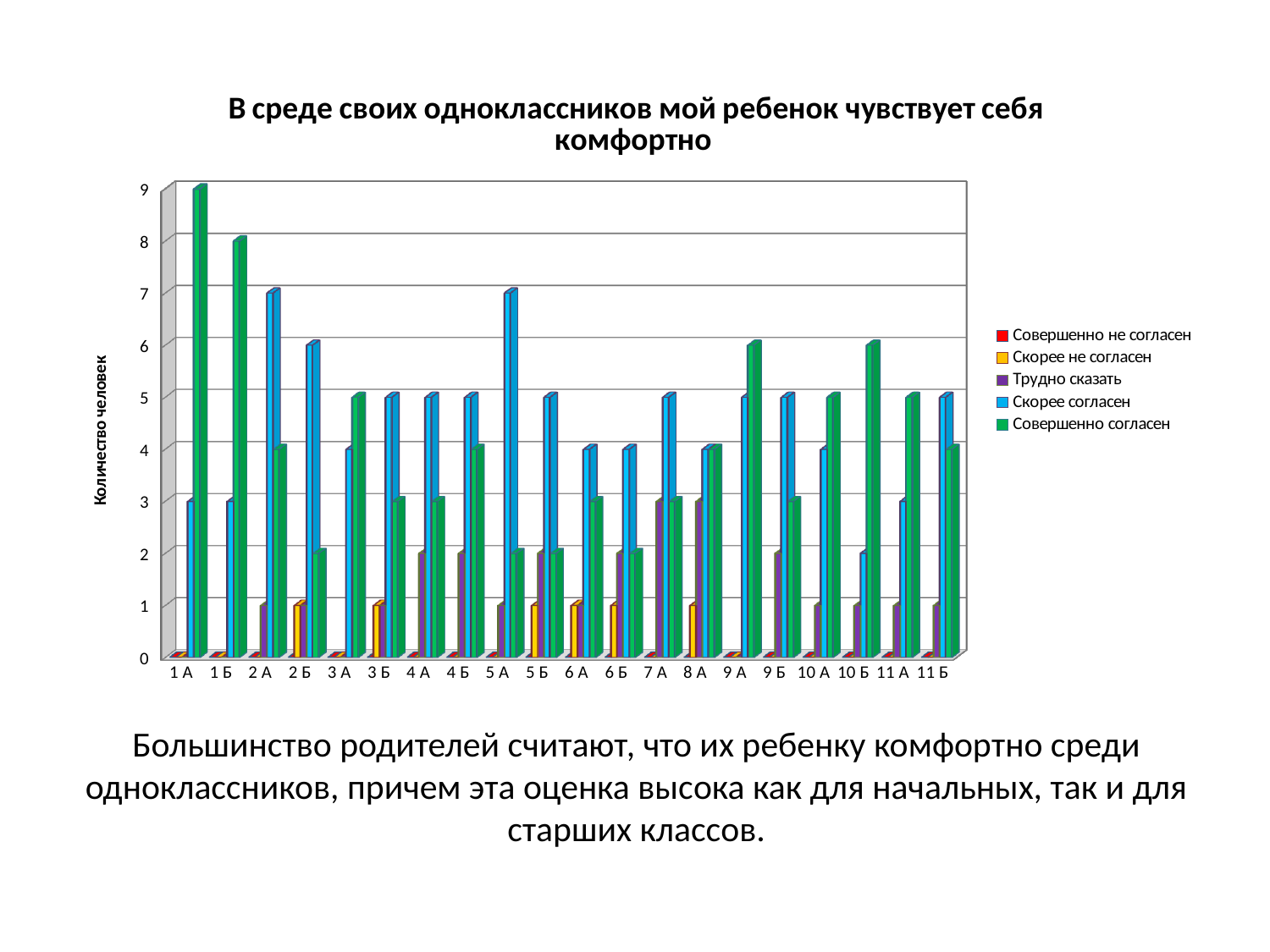
What kind of chart is shown on the slide? bar chart What is the value for 'Совершенно согласен' in class 1 Б? 8 What is the value for 'Совершенно согласен' in class 1 А? 9 What is the label of the vertical axis? Количество человек Which is larger: 'Совершенно согласен' in class 1 А or in class 1 Б? 1 А In class 10 Б, which is larger: 'Совершенно согласен' or 'Скорее согласен'? Совершенно согласен Is the value for 'Скорее согласен' in class 10 Б greater or less than 3? less What is the title of the chart? В среде своих одноклассников мой ребенок чувствует себя комфортно How many class categories are shown along the x axis? 20 Is the value for 'Скорее согласен' in class 2 А greater or less than 6? greater Which class has the highest value for the series 'Совершенно согласен'? 1 А How many series does the legend list? 5